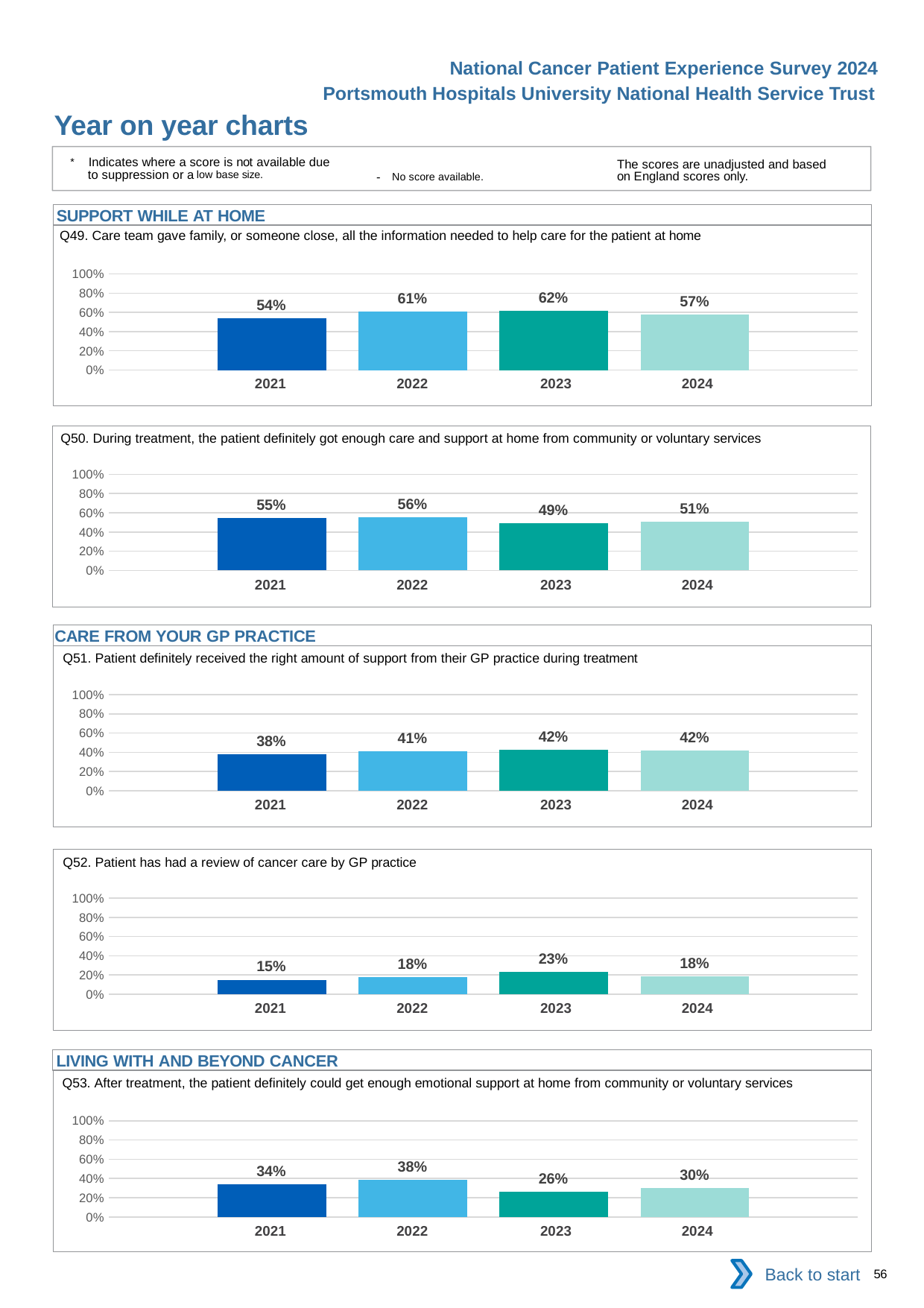
In the Q52 chart, what is the difference between the 2023 and 2021 values? 8% In the Q50 chart, what is the difference between the 2022 and 2023 values? 7% In the Q53 chart, which is larger, the value for 2022 or the value for 2024? 2022 In the Q53 chart, what is the value for 2023? 26% In the Q51 chart, is the value for 2024 greater or less than 60%? less In the Q52 chart, which year has the highest value? 2023 In the Q50 chart, which year has the highest value? 2022 In the Q49 chart, what is the value for 2023? 62% In the Q49 chart, which year has the lowest value? 2021 In the Q51 chart, what is the value for 2021? 38% What type of chart is the Q52 chart? Bar chart How many years are shown on the x axis of the Q49 chart? 4